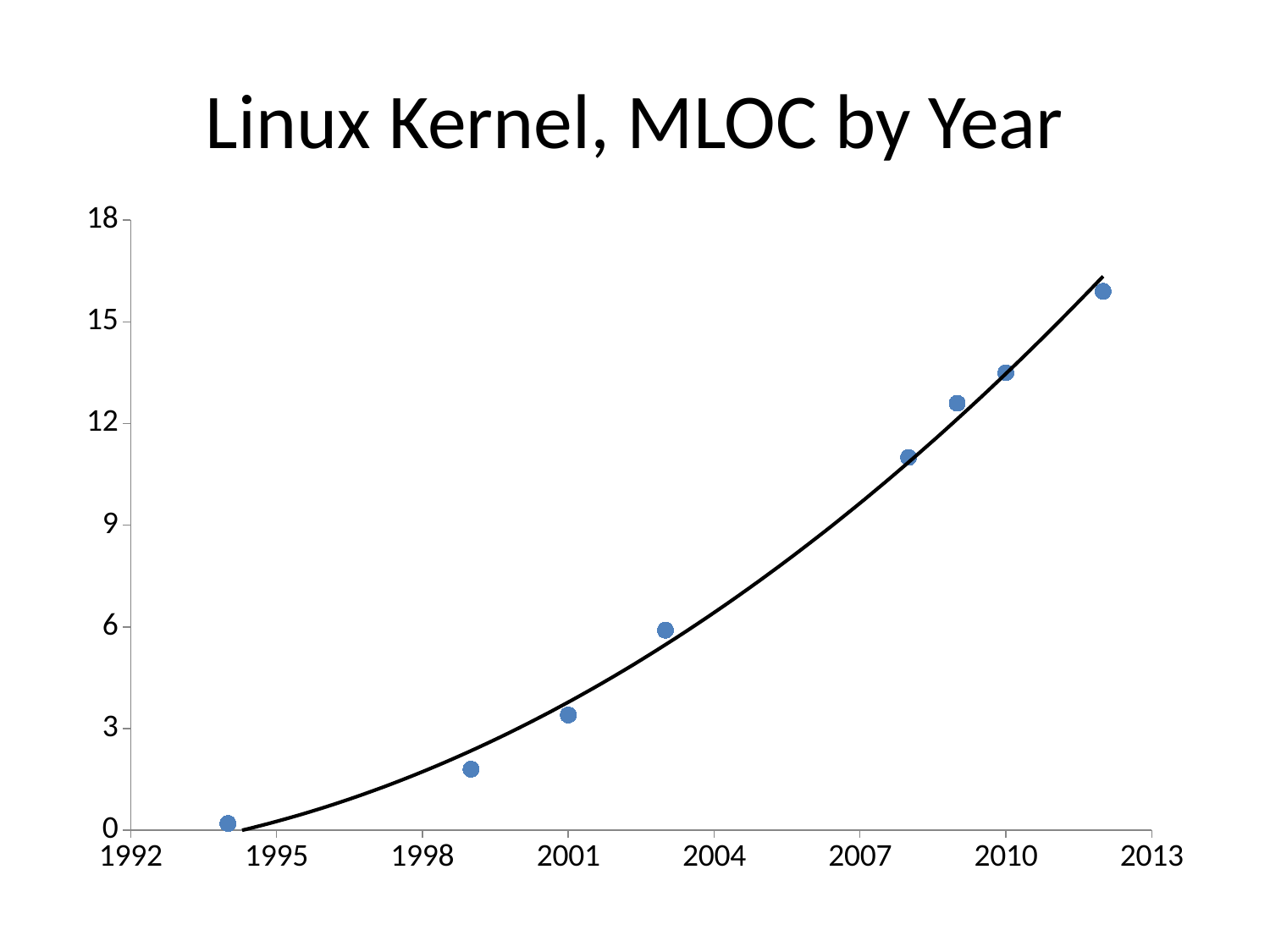
Is the value of the leftmost data point greater or less than 3? less Is the value of the data point at 2008 greater or less than 9? greater Is the value of the rightmost data point greater or less than 18? less Do the plotted values rise or fall as the year increases along the x axis? rise What is the highest value shown on the y axis? 18 How many data points are plotted on the chart? 8 What kind of chart is shown on the slide? scatter chart Which data point has the highest value: the one at the earliest year or the one at the latest year? the one at the latest year Which is larger: the value of the data point at 2003 or the value of the data point at 2009? 2009 What is the title of the chart? Linux Kernel, MLOC by Year